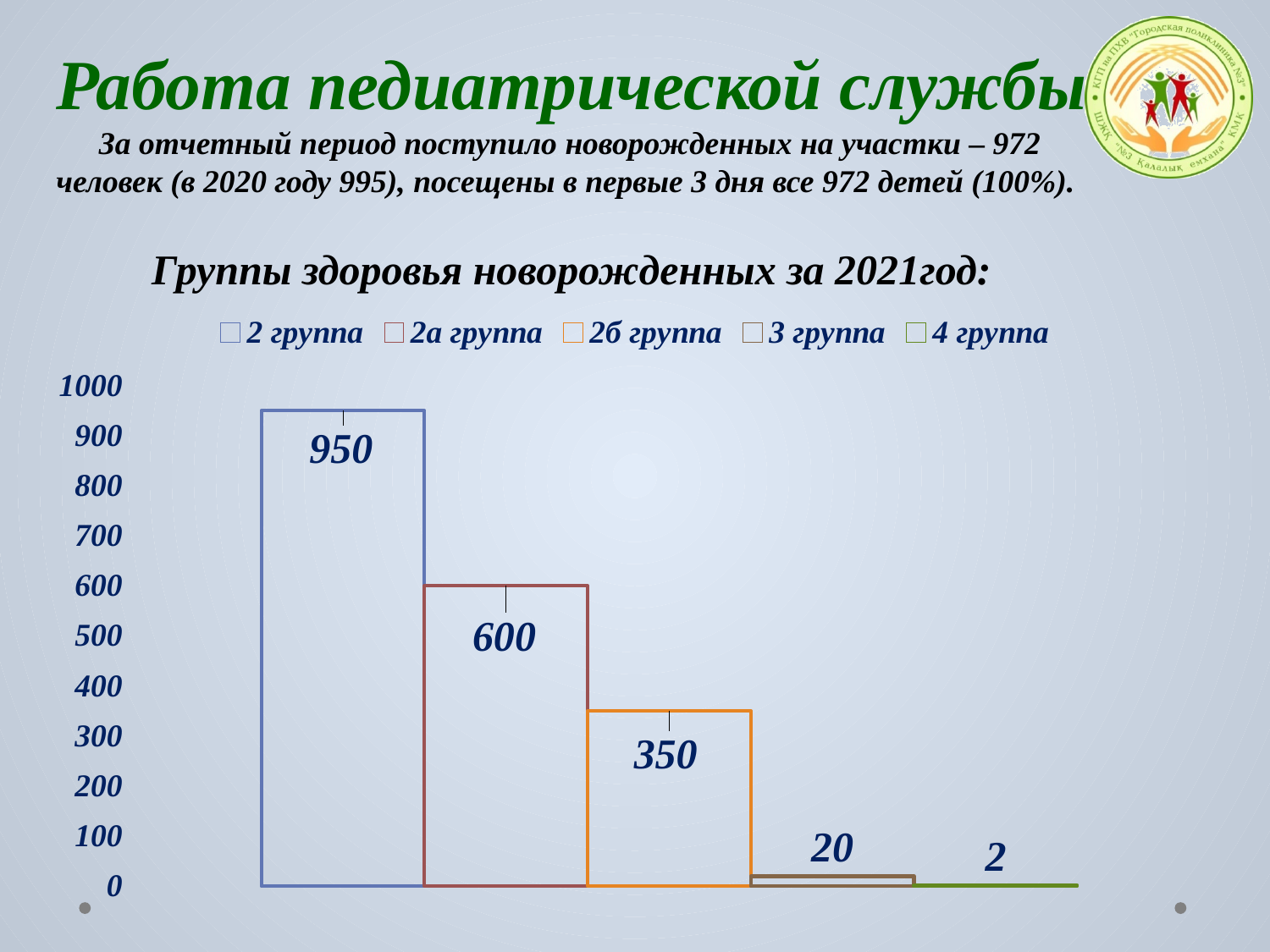
What is the difference between the values for 2 группа and 2а группа? 350 What is the value for 2б группа? 350 What is the value for 3 группа? 20 What is the title of the chart? Группы здоровья новорожденных за 2021год: What kind of chart is shown on the slide? Bar chart How many series does the legend list? 5 What is the value for 2а группа? 600 What is the value for 2 группа? 950 Which group has the lowest value? 4 группа What is the value for 4 группа? 2 Which group has the highest value? 2 группа Which is larger, the value for 2б группа or the value for 3 группа? 2б группа